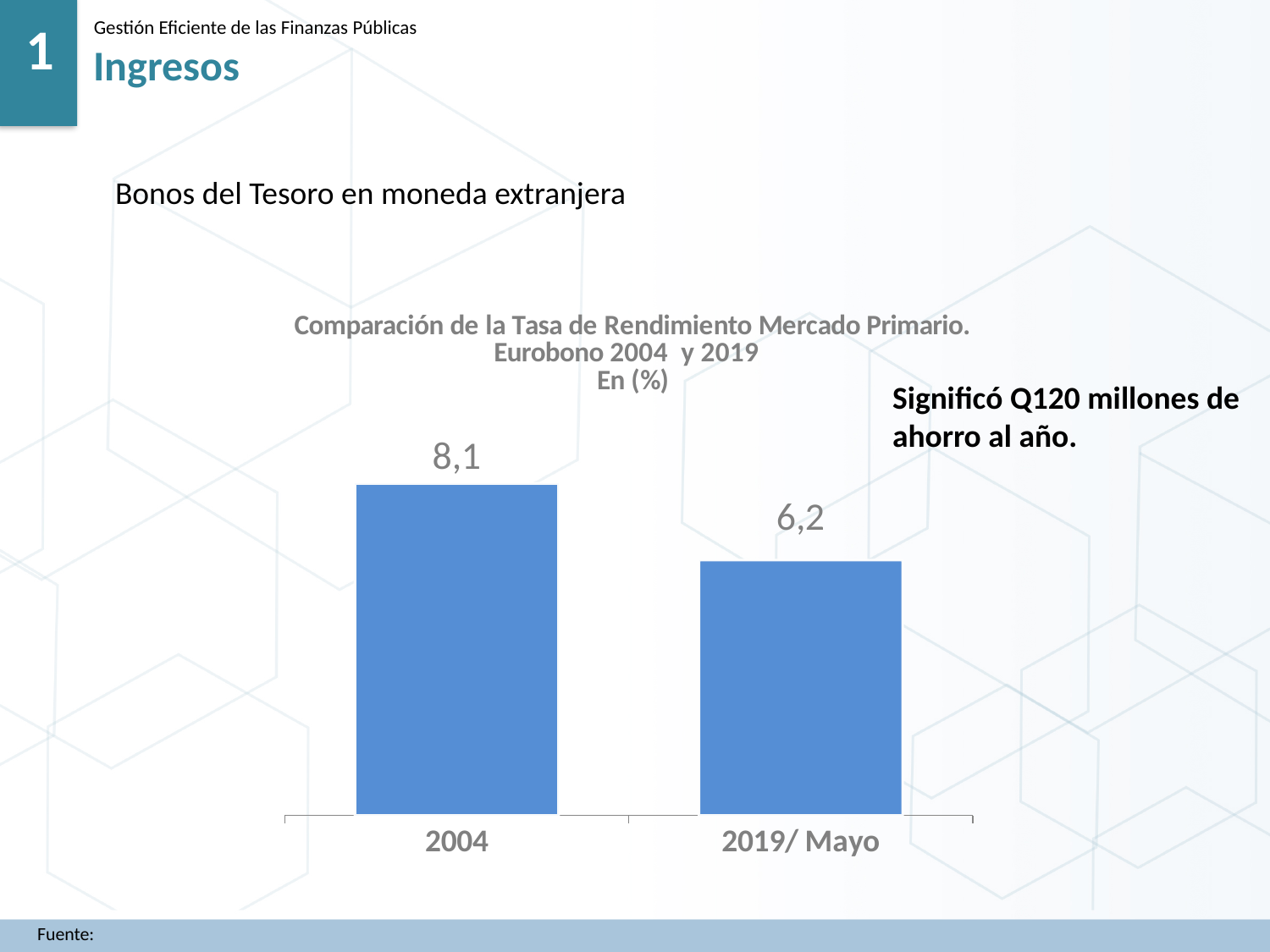
Which category has the highest value? 2004 What colour are the bars in the chart? blue What is the value for 2004? 8,1 How many categories are shown on the x axis? 2 Do the values rise or fall from 2004 to 2019/ Mayo? fall What is the title of the chart? Comparación de la Tasa de Rendimiento Mercado Primario. Eurobono 2004 y 2019 En (%) What is the difference between the values for 2004 and 2019/ Mayo? 1,9 Which category has the lowest value? 2019/ Mayo What is the value for 2019/ Mayo? 6,2 What kind of chart is shown? bar chart Which is larger, the value for 2004 or the value for 2019/ Mayo? 2004